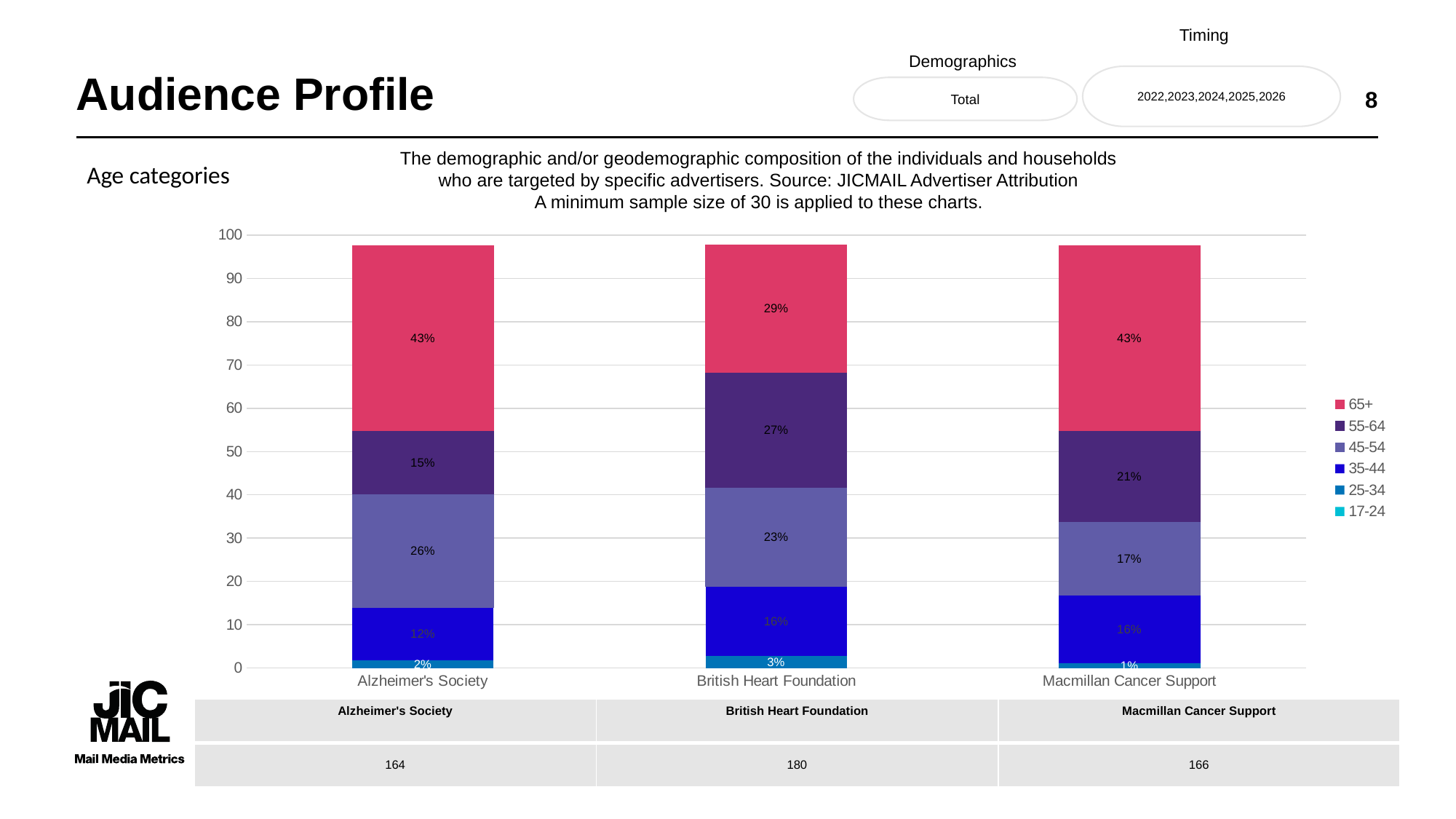
What is the 55-64 share for British Heart Foundation? 27% Which advertiser has the lowest 65+ share? British Heart Foundation Which is larger: the 45-54 share for Alzheimer's Society or for Macmillan Cancer Support? Alzheimer's Society What percentage of the Alzheimer's Society audience is aged 65+? 43% How many age categories does the legend list? 6 Which advertiser has the highest 55-64 share? British Heart Foundation What kind of chart is shown on the slide? Stacked bar chart What is the difference in percentage points between the 45-54 share for Alzheimer's Society and for Macmillan Cancer Support? 9 percentage points How many advertisers are shown on the x axis of the chart? 3 What is the 45-54 value for Macmillan Cancer Support? 17% Is the 35-44 share for Alzheimer's Society greater or less than the 35-44 share for British Heart Foundation? less What is the 25-34 share for British Heart Foundation? 3%